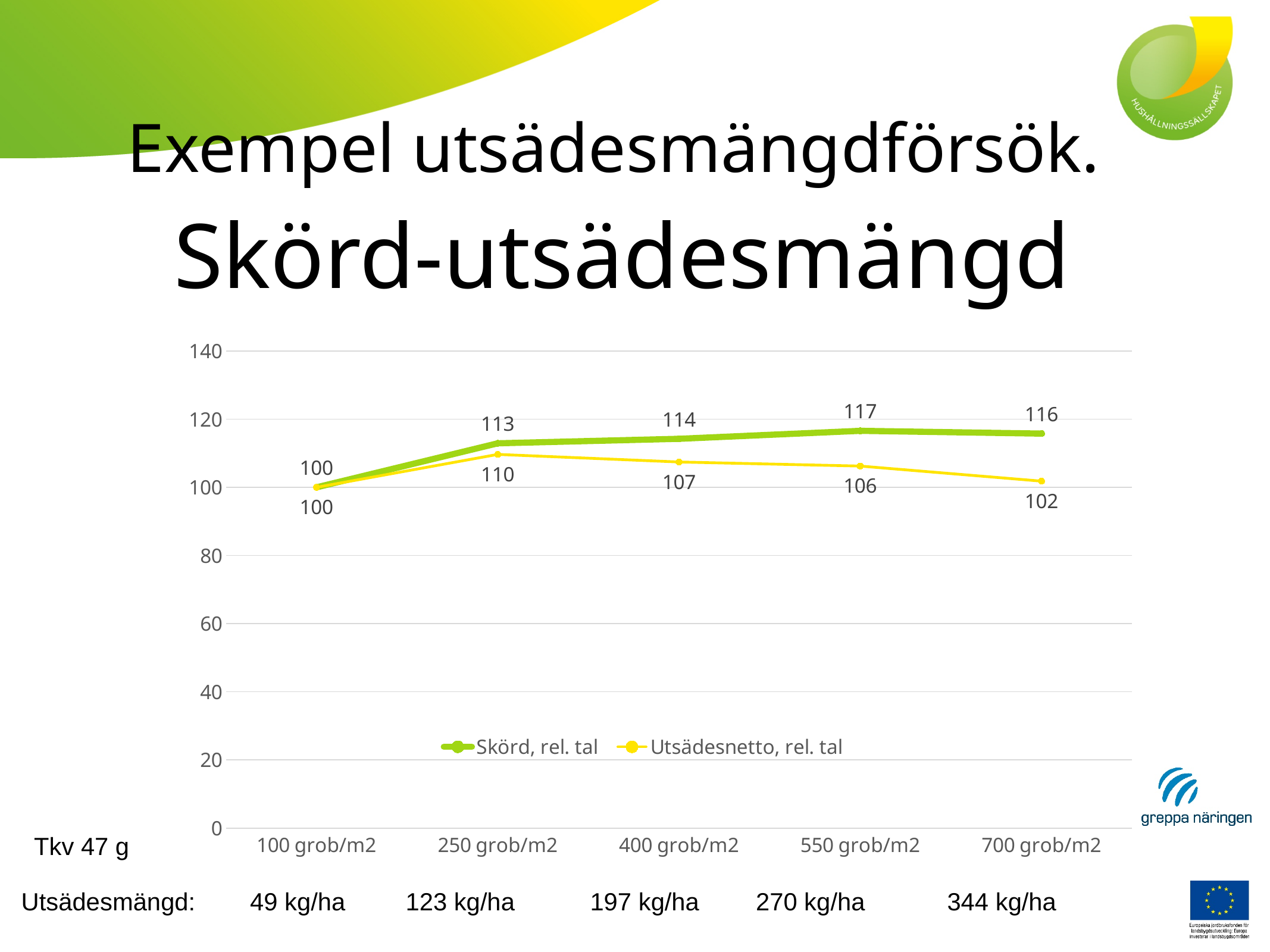
How many series does the legend list? 2 At which seed rate category is Skörd, rel. tal highest? 550 grob/m2 What is the difference between Skörd, rel. tal and Utsädesnetto, rel. tal at 700 grob/m2? 14 What is the value of Utsädesnetto, rel. tal at 250 grob/m2? 110 What colour is the line for Skörd, rel. tal? green What kind of chart is shown on the slide? line chart Does Utsädesnetto, rel. tal rise or fall from 250 grob/m2 to 700 grob/m2? fall What is the value of Skörd, rel. tal at 550 grob/m2? 117 How many seed rate categories are shown on the x axis? 5 At which seed rate category is Utsädesnetto, rel. tal lowest? 700 grob/m2 Which series has the larger value at 400 grob/m2, Skörd, rel. tal or Utsädesnetto, rel. tal? Skörd, rel. tal What is the value of Utsädesnetto, rel. tal at 700 grob/m2? 102